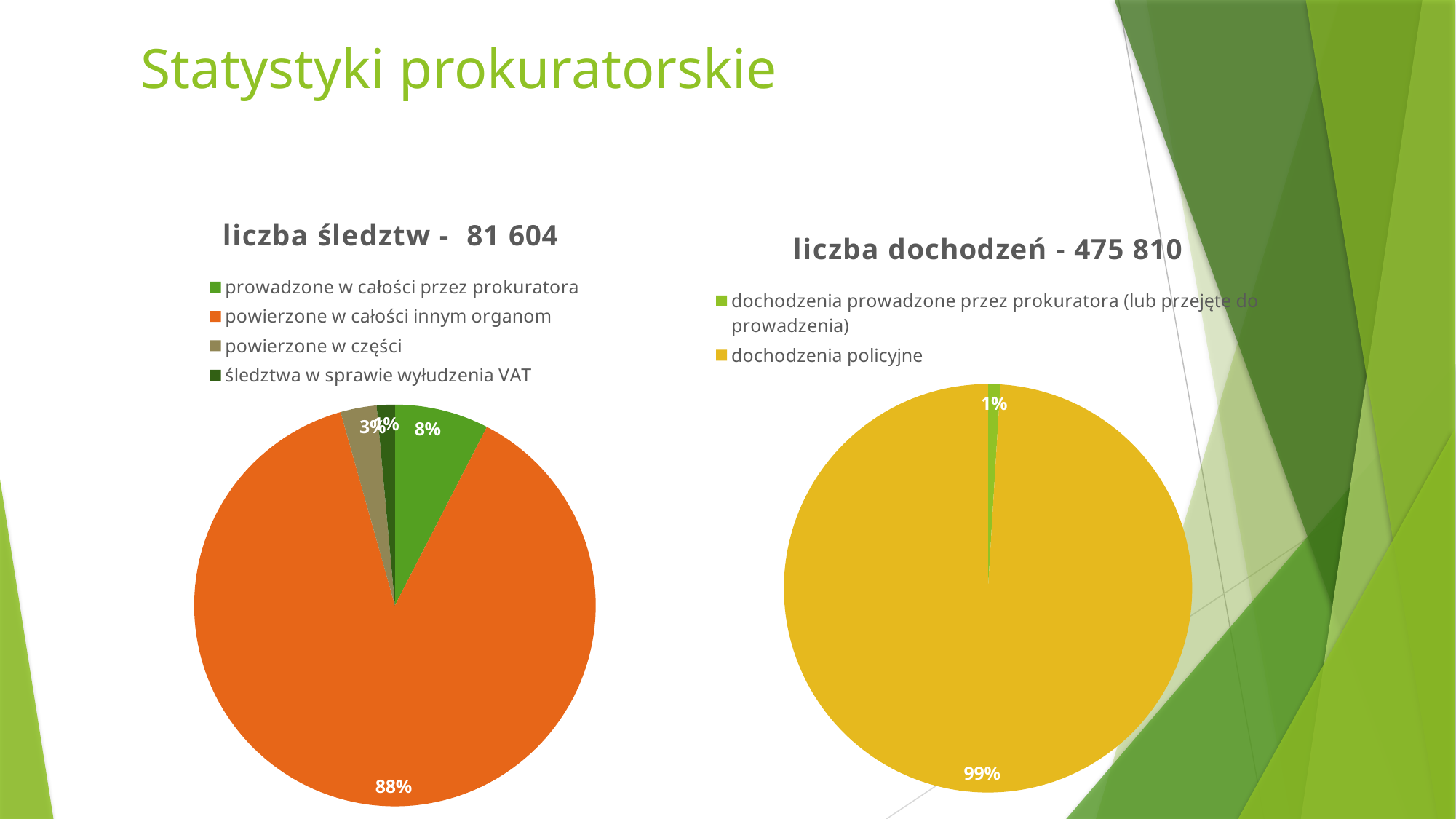
What type of chart is the chart titled "liczba dochodzeń - 475 810"? Pie chart In the chart titled "liczba dochodzeń - 475 810", what share is labelled for "dochodzenia prowadzone przez prokuratora (lub przejęte do prowadzenia)"? 1% In the chart titled "liczba śledztw - 81 604", how many percentage points larger is "powierzone w całości innym organom" than "prowadzone w całości przez prokuratora"? 80 percentage points In the chart titled "liczba śledztw - 81 604", which is larger: "prowadzone w całości przez prokuratora" or "powierzone w części"? prowadzone w całości przez prokuratora In the chart titled "liczba śledztw - 81 604", what share is labelled for "powierzone w całości innym organom"? 88% In the chart titled "liczba dochodzeń - 475 810", which category has the smallest slice? dochodzenia prowadzone przez prokuratora (lub przejęte do prowadzenia) In the chart titled "liczba śledztw - 81 604", what share is labelled for "powierzone w części"? 3% In the chart titled "liczba śledztw - 81 604", what share is labelled for "prowadzone w całości przez prokuratora"? 8% How many categories does the legend of the chart titled "liczba dochodzeń - 475 810" list? 2 How many categories does the legend of the chart titled "liczba śledztw - 81 604" list? 4 In the chart titled "liczba śledztw - 81 604", which category has the largest slice? powierzone w całości innym organom In the chart titled "liczba dochodzeń - 475 810", what share is labelled for "dochodzenia policyjne"? 99%